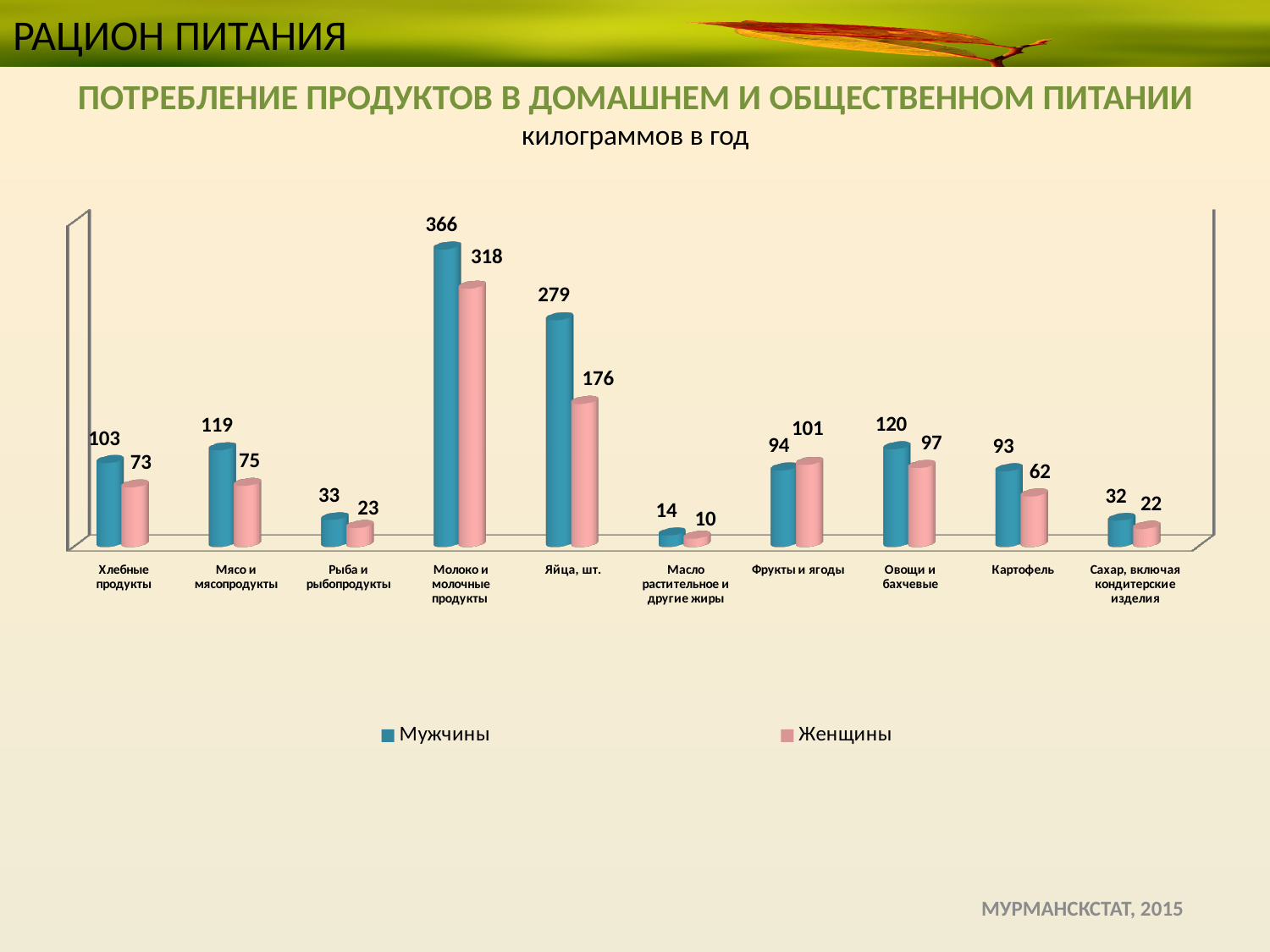
Which category has the highest value for Мужчины? Молоко и молочные продукты What unit is stated in the subtitle under the chart title? килограммов в год What is the difference between the Мужчины and Женщины values for Яйца, шт.? 103 How many series does the legend list? 2 What is the value for Женщины in the Яйца, шт. category? 176 Which is larger in the Фрукты и ягоды category, the value for Мужчины or for Женщины? Женщины What is the difference between the Мужчины and Женщины values for Картофель? 31 What is the value for Мужчины in the Молоко и молочные продукты category? 366 Which category has the lowest value for Женщины? Масло растительное и другие жиры How many categories are shown on the x axis? 10 What kind of chart is shown on the slide? Bar chart What is the value for Женщины in the Хлебные продукты category? 73